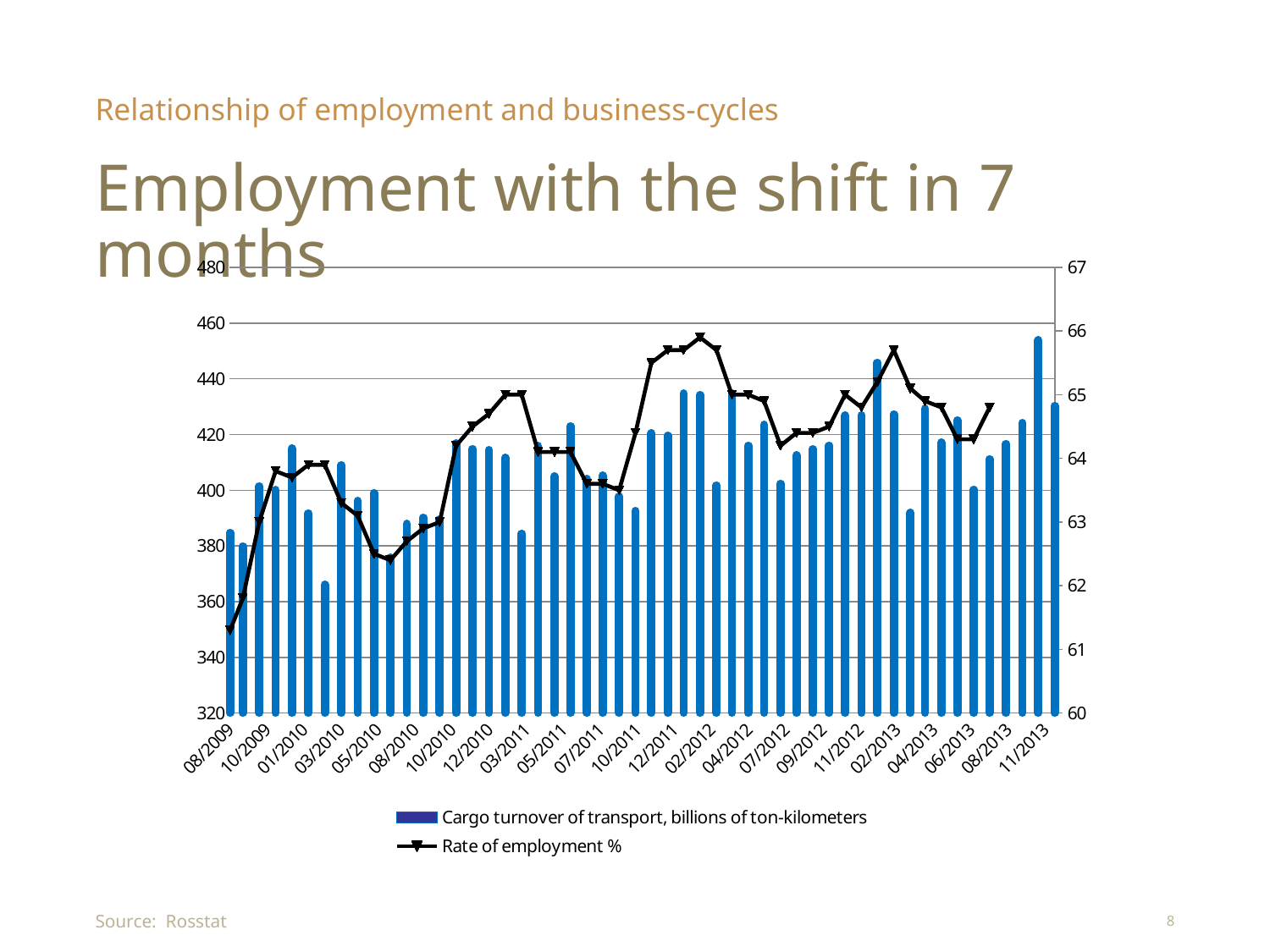
Does the rate of employment line rise or fall from 08/2009 to 01/2010? rise Is the rate of employment for 08/2009 greater or less than 62? less Which is larger, the cargo turnover bar for 11/2013 or the bar for 03/2010? 11/2013 How many series does the legend list? 2 Is the rate of employment for 02/2012 greater or less than 65? greater What kind of chart is shown on the slide? A combined bar and line chart Which series is plotted as bars? Cargo turnover of transport, billions of ton-kilometers Which series is plotted as a line with triangle markers? Rate of employment % Which month has the lowest rate of employment on the line? 08/2009 What is the highest value shown on the right-hand axis? 67